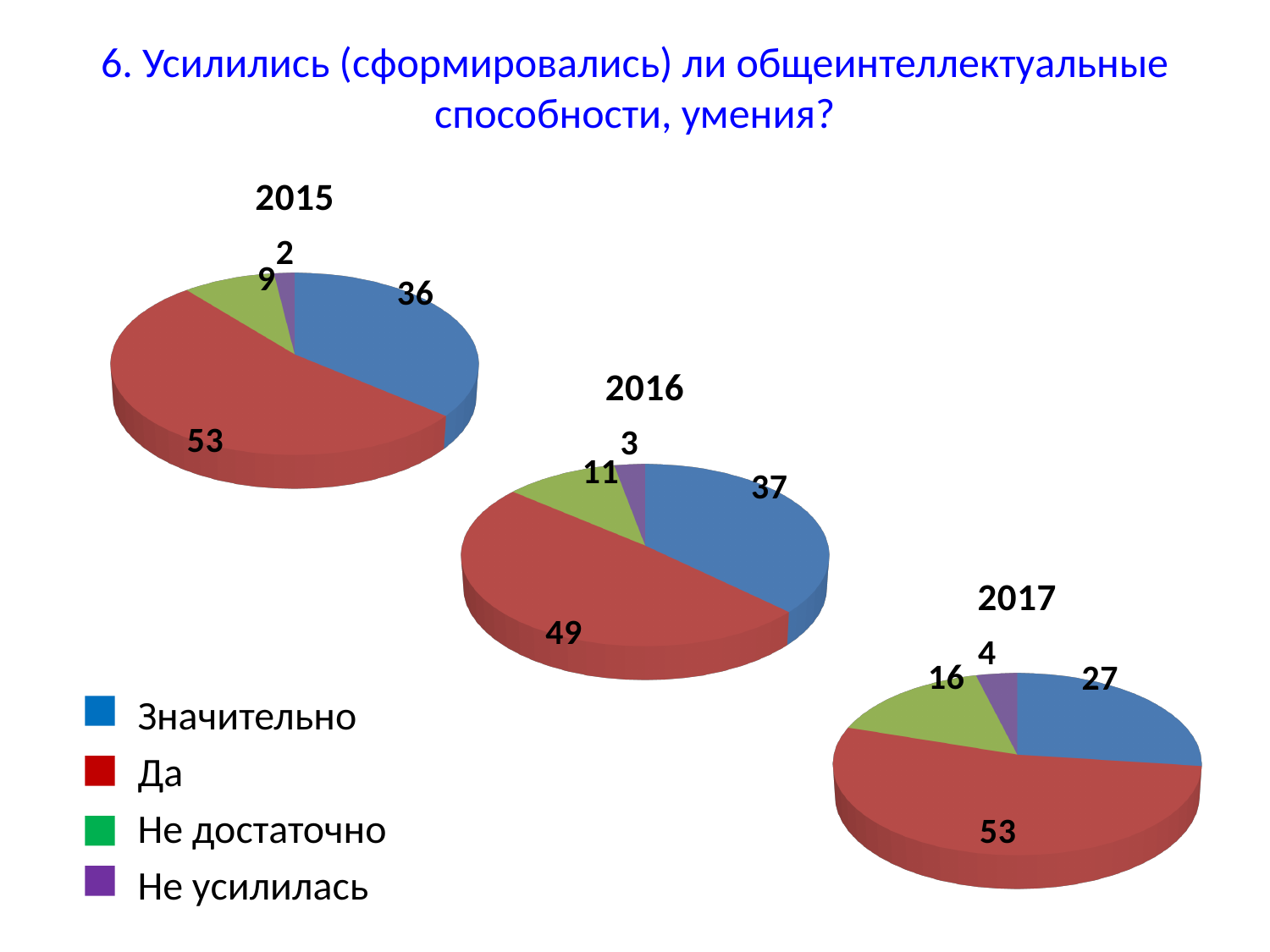
Across the 2015, 2016 and 2017 pie charts, does the value for "Не достаточно" rise or fall over the years? Rise In the 2015 pie chart, which category has the smallest slice? Не усилилась In the 2017 pie chart, which category has the largest slice? Да In the 2016 pie chart, what is the value for "Значительно"? 37 In the 2017 pie chart, what is the value for "Не достаточно"? 16 How many slices does the 2016 pie chart have? 4 In the 2017 pie chart, which is larger: "Значительно" or "Не достаточно"? Значительно In the 2015 pie chart, what is the value for "Да"? 53 What kind of chart is used for the 2015 data? Pie chart In the 2016 pie chart, what is the difference between the values for "Да" and "Значительно"? 12 How many entries does the legend list? 4 Which colour represents "Не усилилась" in the legend? Purple